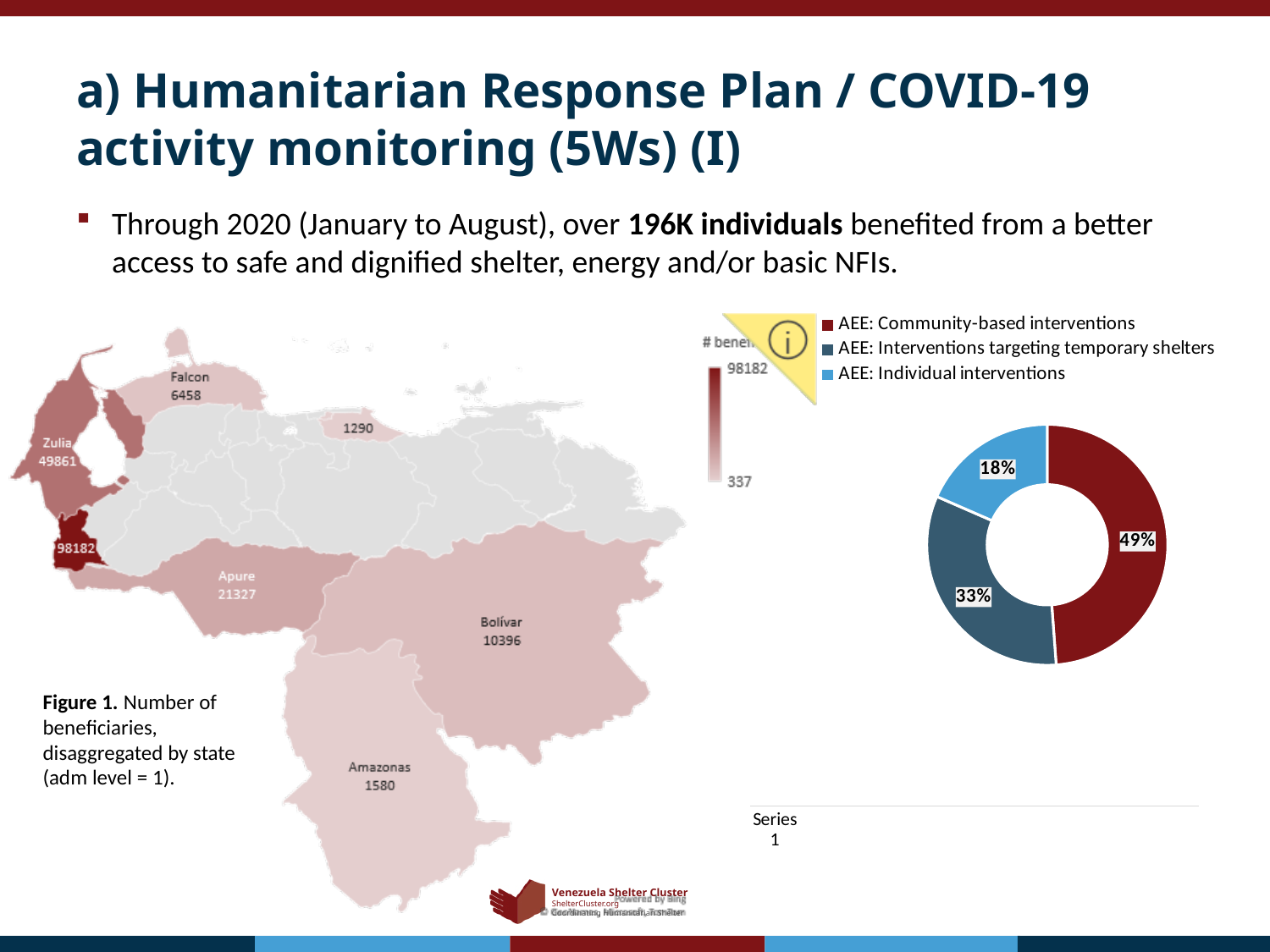
In the doughnut chart, which is larger: the share for AEE: Interventions targeting temporary shelters or the share for AEE: Individual interventions? AEE: Interventions targeting temporary shelters In the doughnut chart, which category has the largest share? AEE: Community-based interventions In the doughnut chart, what colour is the slice for AEE: Community-based interventions? Dark red In the doughnut chart, what share is shown for AEE: Interventions targeting temporary shelters? 33% What kind of chart is shown on the right side of the slide? Doughnut chart In the doughnut chart, what share is shown for AEE: Individual interventions? 18% How many entries does the legend of the doughnut chart list? 3 In the doughnut chart, what share is shown for AEE: Community-based interventions? 49% How many slices does the doughnut chart have? 3 In the doughnut chart, what is the difference in percentage points between AEE: Community-based interventions and AEE: Individual interventions? 31 percentage points On the map in Figure 1, what is the number of beneficiaries shown for Zulia? 49861 In the doughnut chart, which category has the smallest share? AEE: Individual interventions